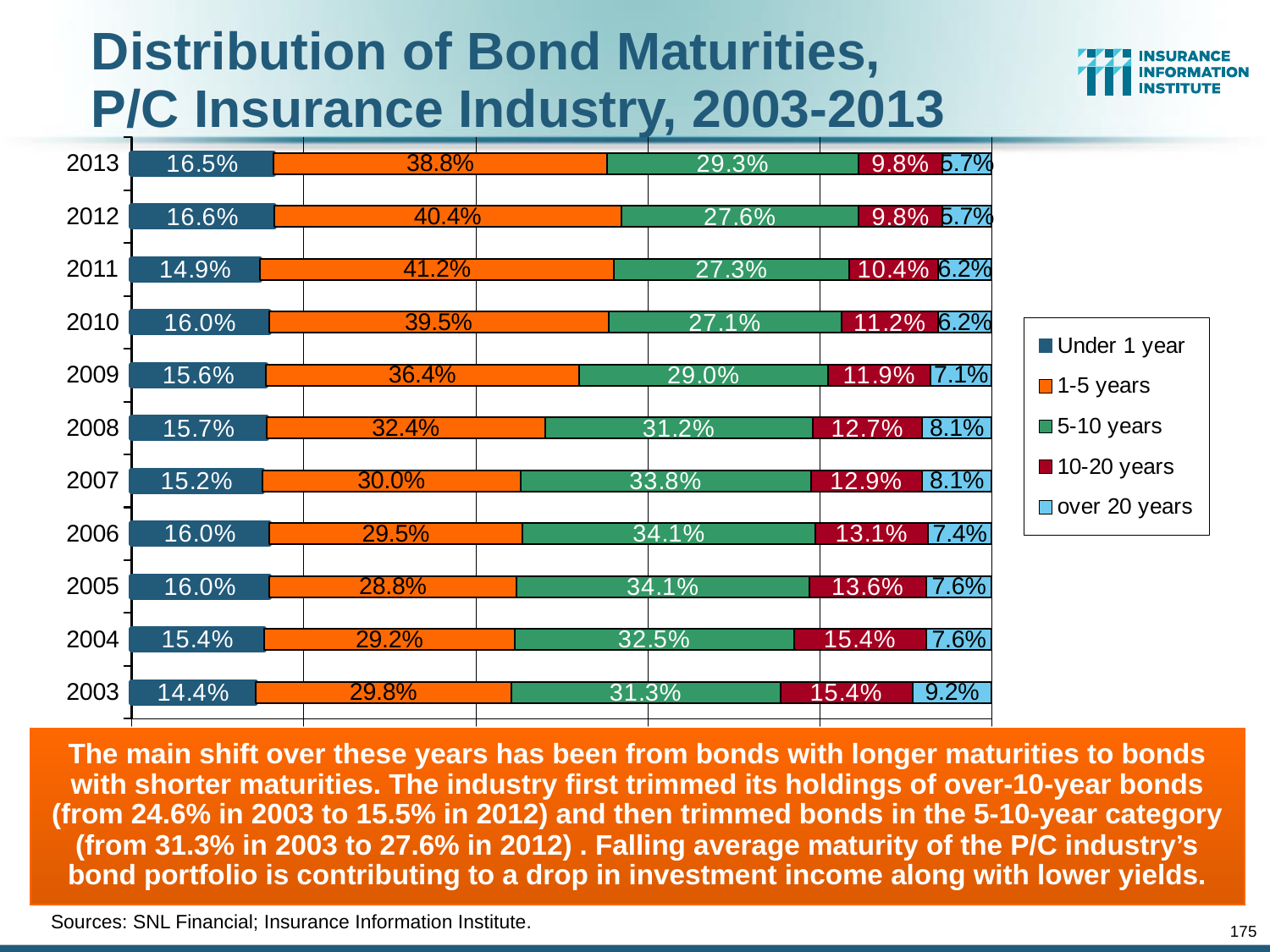
What type of chart is shown on the slide? Stacked bar chart What share of bonds had maturities of over 20 years in 2003? 9.2% How many years are shown on the chart? 11 What is the value for the Under 1 year category in 2012? 16.6% Which is larger: the 5-10 years share in 2007 or in 2013? 2007 What share of bonds had maturities of 1-5 years in 2011? 41.2% By how many percentage points did the 1-5 years share in 2013 exceed the 1-5 years share in 2003? 9.0 percentage points In which year was the over 20 years share the highest? 2003 In which year was the 1-5 years share the highest? 2011 In which year was the 1-5 years share the lowest? 2005 How many maturity categories does the legend list? 5 What is the value for the 5-10 years category in 2007? 33.8%